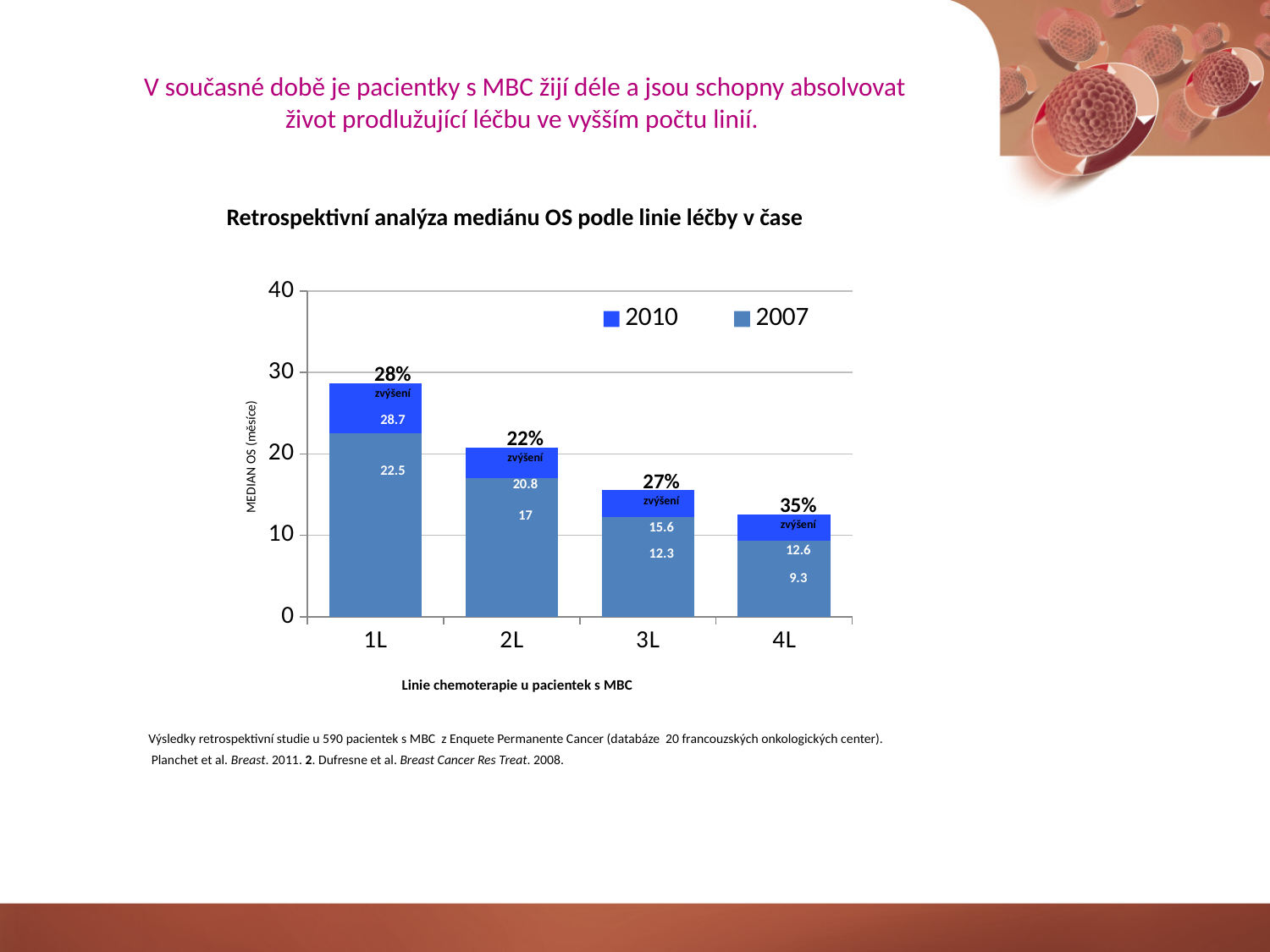
How many series does the legend list? 2 Which line of chemotherapy has the highest median OS in 2007? 1L Which line of chemotherapy has the lowest median OS in 2010? 4L What is the median OS for 3L in 2007? 12.3 What is the difference between the 2010 and 2007 median OS values for 2L? 3.8 What is the median OS for 4L in 2010? 12.6 What is the median OS for 1L in 2010? 28.7 What percentage increase is shown above the 4L bars? 35% Do the median OS values rise or fall from 1L to 4L? fall How many lines of chemotherapy are shown on the x axis? 4 Which is larger: the 2007 median OS for 1L or the 2010 median OS for 2L? 2007 median OS for 1L Is the 2010 median OS for 3L greater or less than 20? less